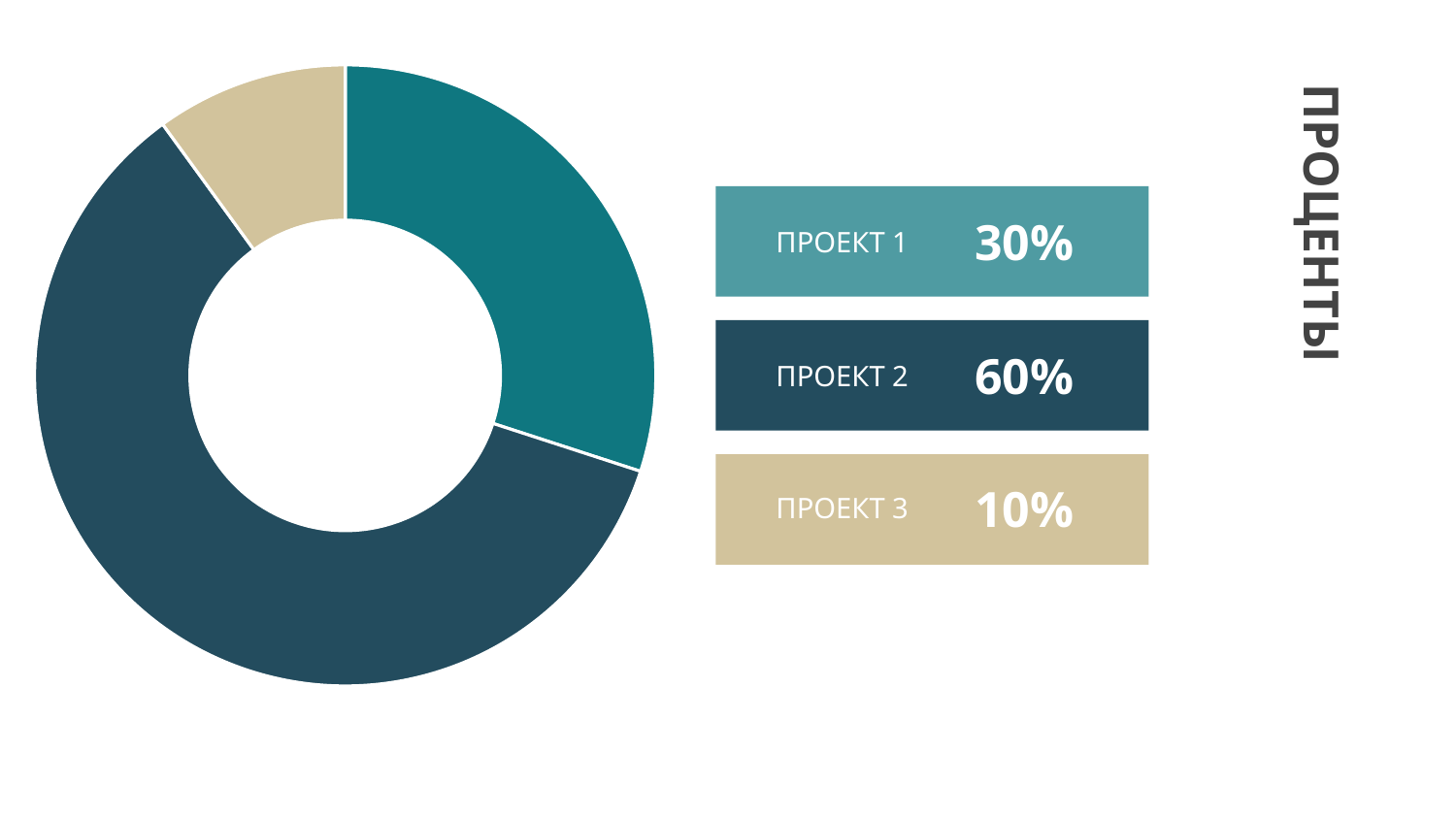
Which is larger, the value for ПРОЕКТ 1 or ПРОЕКТ 3? ПРОЕКТ 1 What is the value for ПРОЕКТ 3? 10% What is the difference between the values for ПРОЕКТ 1 and ПРОЕКТ 3? 20% What colour is the slice for ПРОЕКТ 3? Beige (tan) What is the value for ПРОЕКТ 1? 30% Which project has the largest share of the chart? ПРОЕКТ 2 What kind of chart is shown on the slide? Doughnut (pie) chart How many categories (projects) are shown in the chart? 3 What is the value for ПРОЕКТ 2? 60% What is the title shown on the slide? ПРОЦЕНТЫ Which project has the smallest share of the chart? ПРОЕКТ 3 What is the difference between the values for ПРОЕКТ 2 and ПРОЕКТ 1? 30%